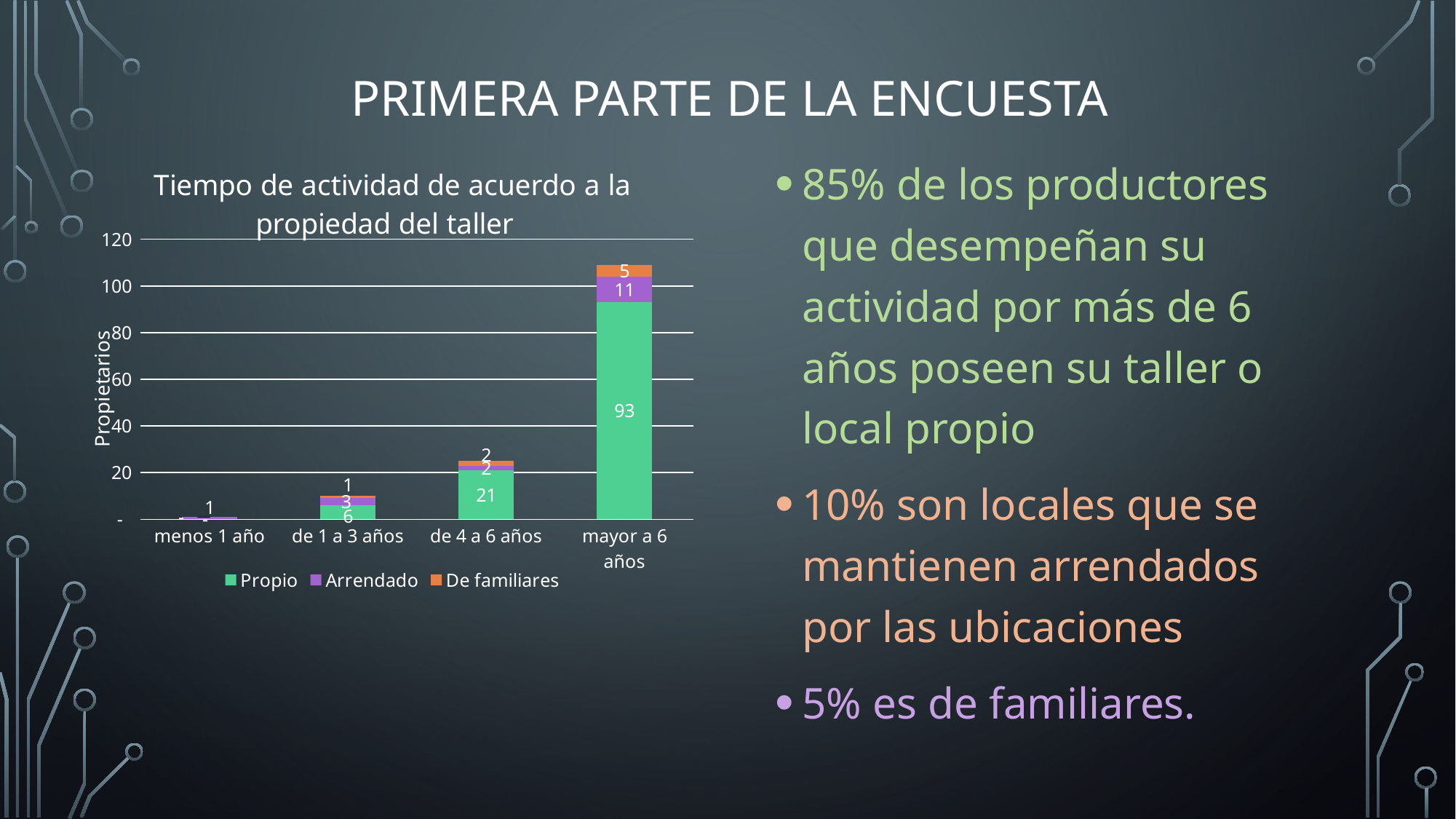
What is the title of the chart? Tiempo de actividad de acuerdo a la propiedad del taller Which is larger: the Arrendado value for 'de 1 a 3 años' or the Arrendado value for 'mayor a 6 años'? mayor a 6 años How many series does the chart legend list? 3 What is the total of the stacked bar for 'mayor a 6 años'? 109 What is the Propio value for 'de 4 a 6 años'? 21 What type of chart is shown on the slide? stacked bar chart What is the De familiares value for 'de 1 a 3 años'? 1 What is the Propio value for 'mayor a 6 años'? 93 Which category has the highest Propio value? mayor a 6 años What is the difference between the Propio values for 'mayor a 6 años' and 'de 4 a 6 años'? 72 How many categories are shown on the x axis of the chart? 4 What is the Arrendado value for 'mayor a 6 años'? 11